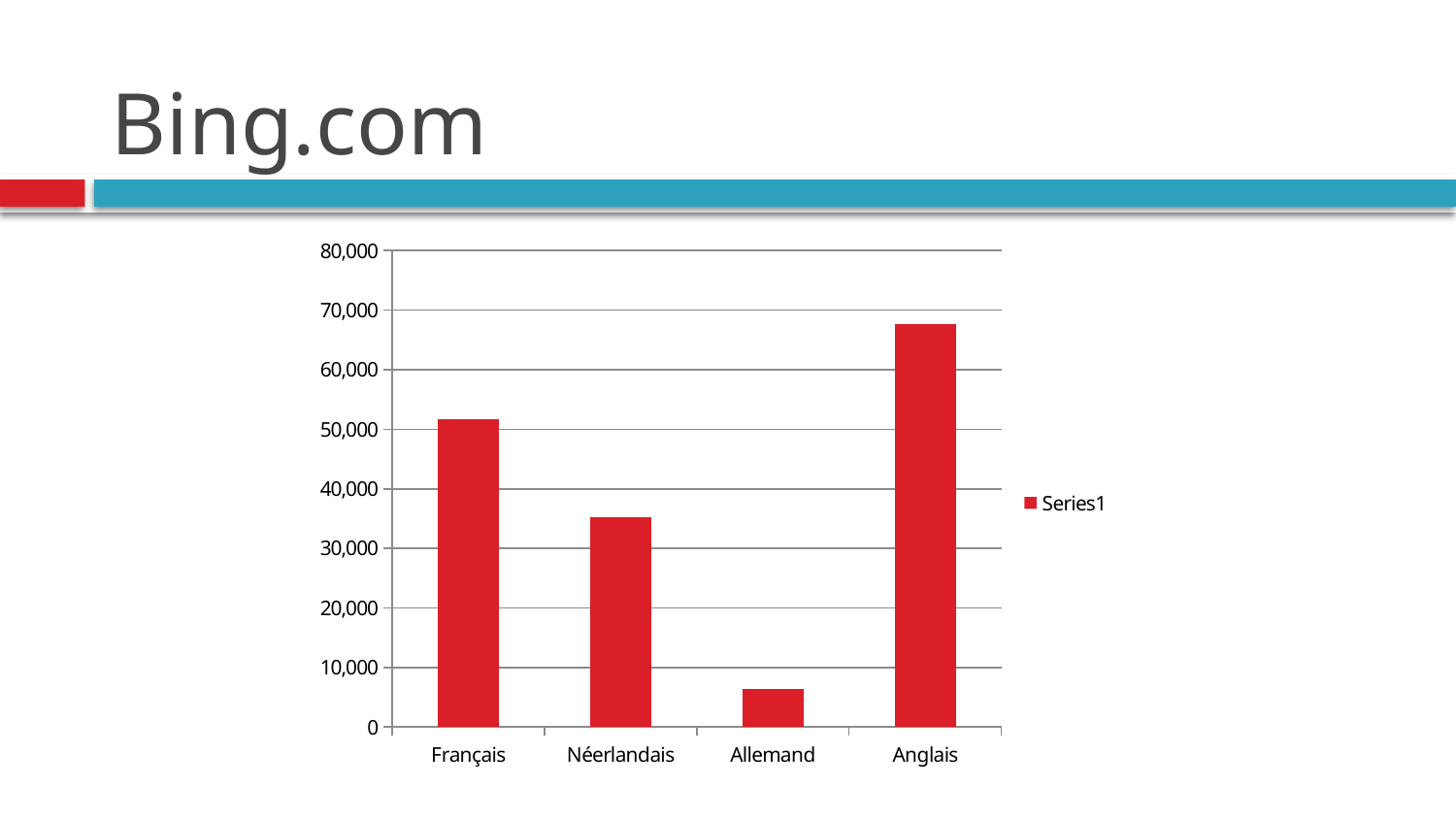
What is the name of the series shown in the legend? Series1 How many series does the legend list? 1 Is the value for Néerlandais greater or less than 40,000? less Which is larger, the value for Français or the value for Néerlandais? Français How many categories are shown on the x axis? 4 Is the value for Allemand greater or less than 10,000? less What kind of chart is shown on the slide? bar chart Which category has the highest bar? Anglais Is the value for Anglais greater or less than 60,000? greater Which category has the lowest bar? Allemand Which is larger, the value for Allemand or the value for Anglais? Anglais